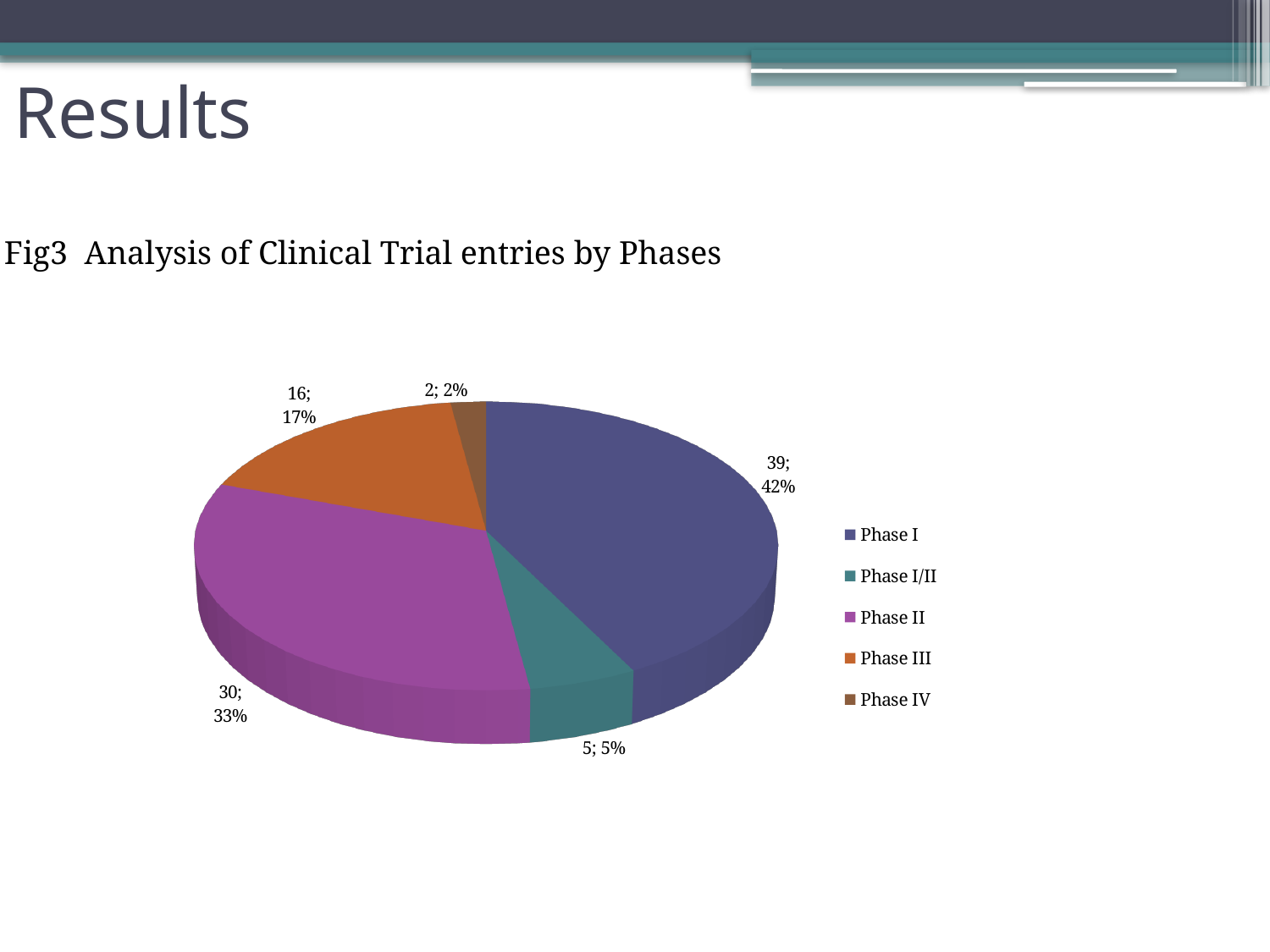
How many entries does the legend list? 5 What is the value for Phase II? 30 How many slices does the pie chart have? 5 What is the value for Phase I? 39 Which phase has the largest slice? Phase I What is the value for Phase III? 16 What percentage share does Phase II have? 33% What is the difference between the values for Phase I and Phase II? 9 Which phase has the smallest slice? Phase IV What kind of chart is shown on the slide? pie chart What is the value for Phase IV? 2 What percentage share does Phase I/II have? 5%